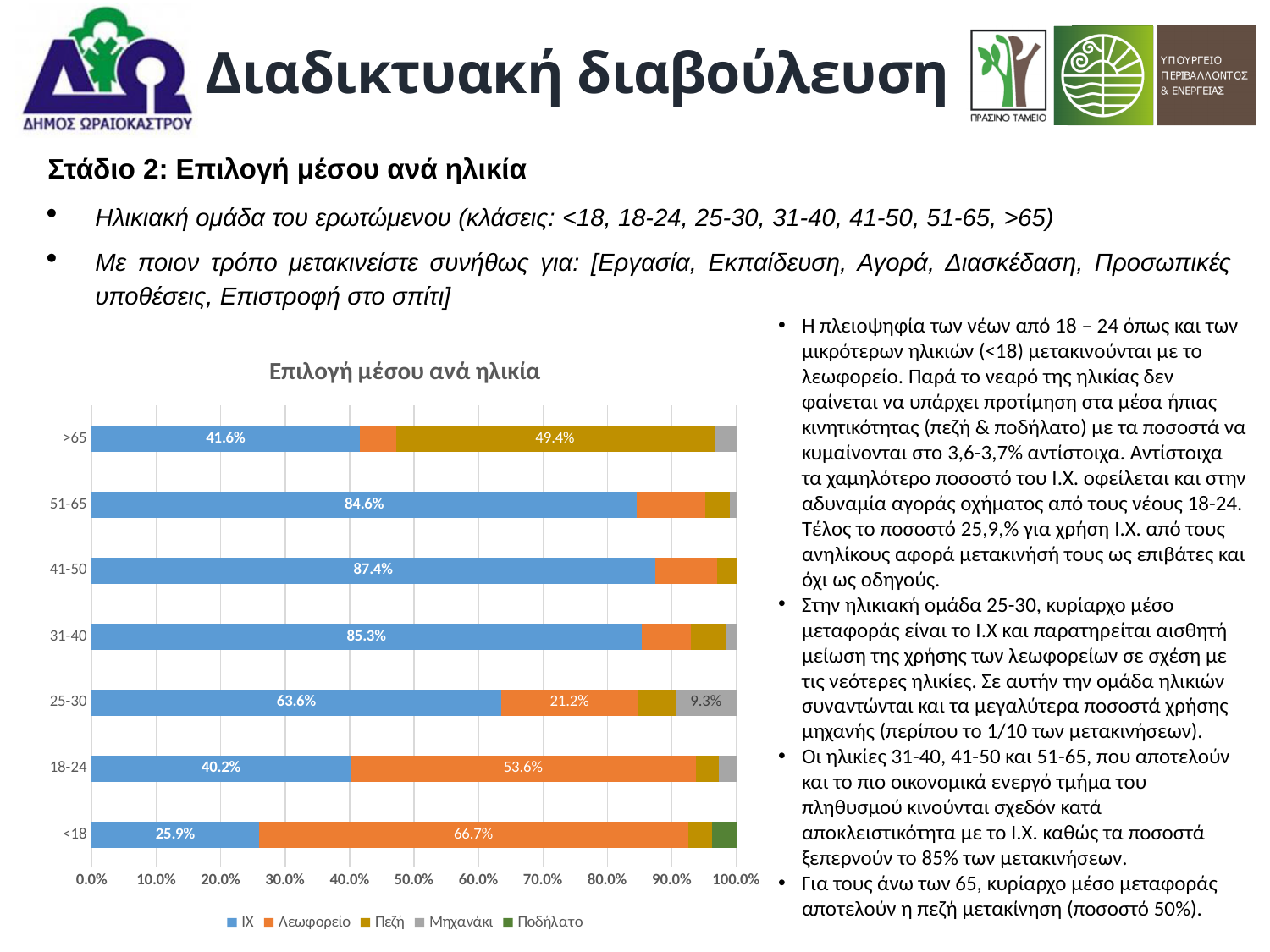
What type of chart is shown on the slide? Stacked bar chart What is the ΙΧ share for the 41-50 age group? 87.4% What is the Πεζή share for the >65 age group? 49.4% Which is larger: the Λεωφορείο share for <18 or for 18-24? <18 Which age group has the highest ΙΧ share? 41-50 What is the title of the chart? Επιλογή μέσου ανά ηλικία Which age group has the lowest ΙΧ share? <18 What is the Μηχανάκι share for the 25-30 age group? 9.3% How many age groups are shown on the chart? 7 What is the Λεωφορείο share for the 18-24 age group? 53.6% How many series does the chart legend list? 5 What is the difference in ΙΧ share between the 41-50 and 51-65 age groups? 2.8 percentage points